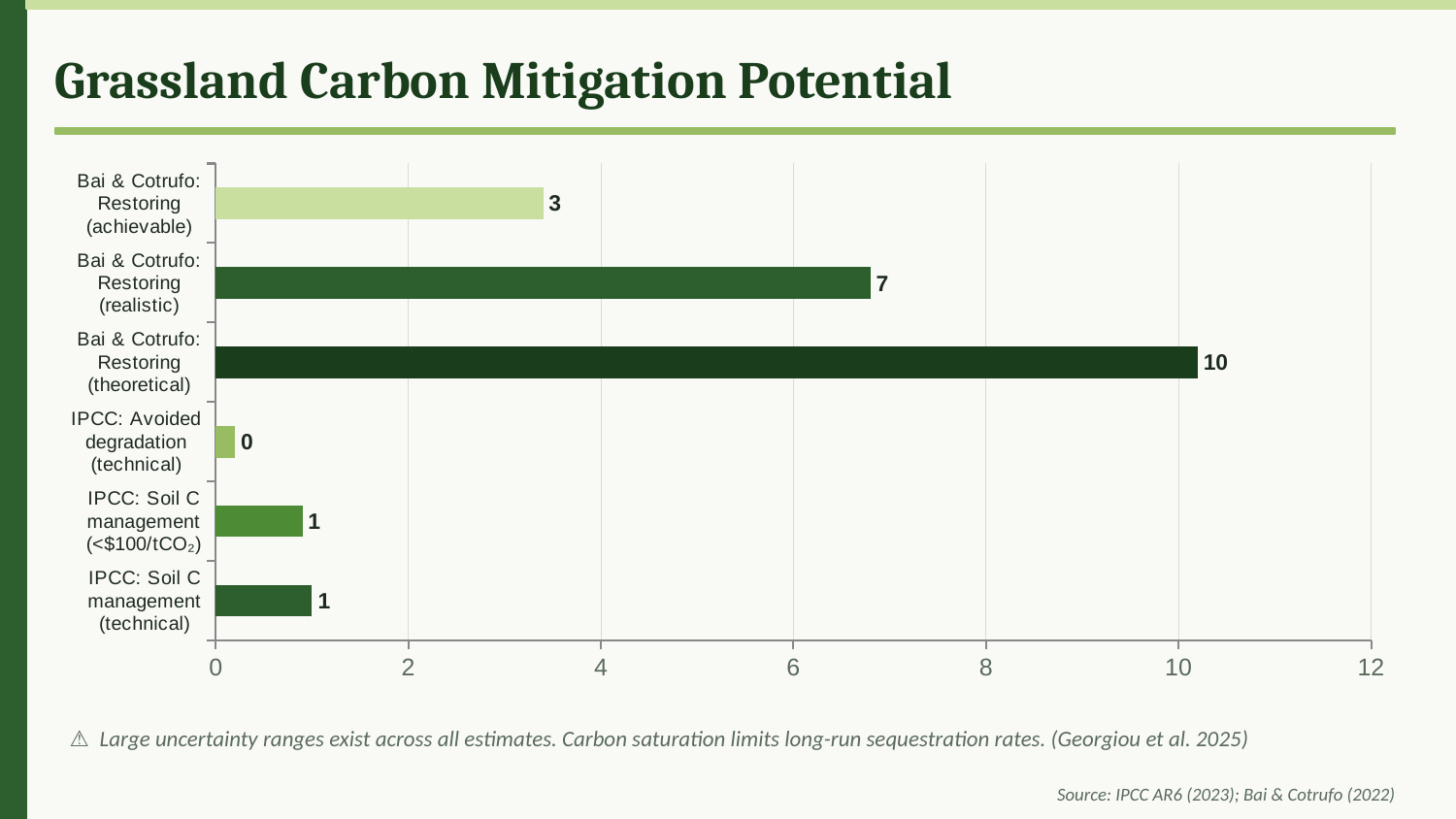
What is the value for IPCC: Soil C management (technical)? 1 How many categories are shown in the chart? 6 What type of chart is shown on the slide? bar chart Is the value for Bai & Cotrufo: Restoring (realistic) greater or less than 6? greater Which category has the lowest value? IPCC: Avoided degradation (technical) What is the value for Bai & Cotrufo: Restoring (realistic)? 7 Which is larger, the value for Bai & Cotrufo: Restoring (realistic) or the value for Bai & Cotrufo: Restoring (achievable)? Bai & Cotrufo: Restoring (realistic) What is the value for IPCC: Avoided degradation (technical)? 0 What is the value for Bai & Cotrufo: Restoring (achievable)? 3 Which category has the highest value? Bai & Cotrufo: Restoring (theoretical) What is the value for Bai & Cotrufo: Restoring (theoretical)? 10 What is the difference between the values for Bai & Cotrufo: Restoring (theoretical) and Bai & Cotrufo: Restoring (realistic)? 3